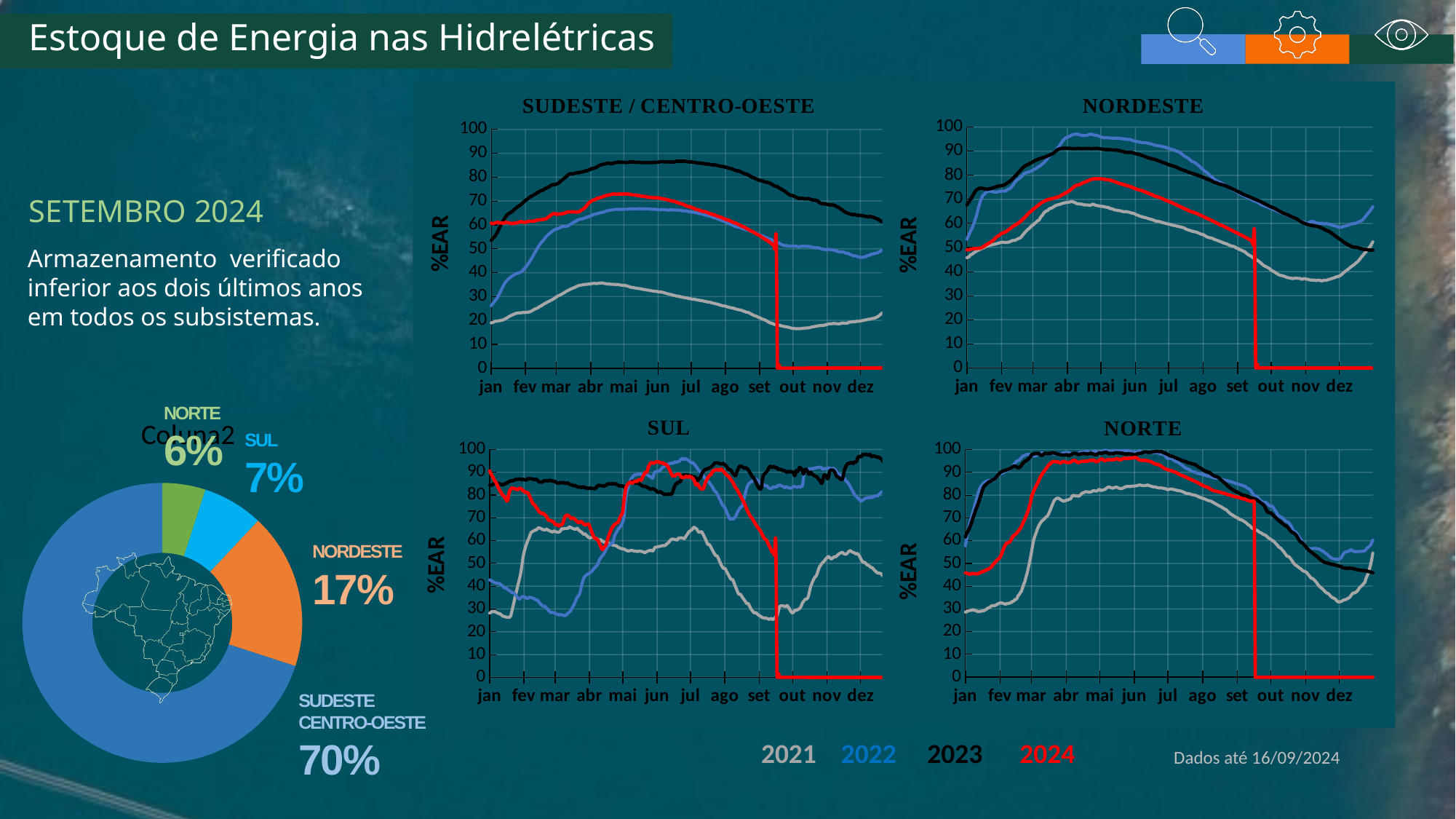
In the donut chart, what share does SUDESTE CENTRO-OESTE have? 70% In the donut chart, which region has the largest slice? SUDESTE CENTRO-OESTE In the donut chart, what is the difference between the NORDESTE share and the SUL share? 10 percentage points What kind of chart is the SUL chart? line chart In the donut chart, which is larger, the SUL share or the NORTE share? SUL How many regions are shown in the donut chart? 4 In the donut chart, which region has the smallest slice? NORTE How many series does the legend below the line charts list? 4 In the donut chart, what share does NORDESTE have? 17% In the SUDESTE / CENTRO-OESTE chart, which line is higher in May, 2023 or 2024? 2023 In the SUDESTE / CENTRO-OESTE chart, is the peak value of the 2021 line greater or less than 40? less In the NORTE chart, does the 2023 line rise or fall from jul to dez? fall